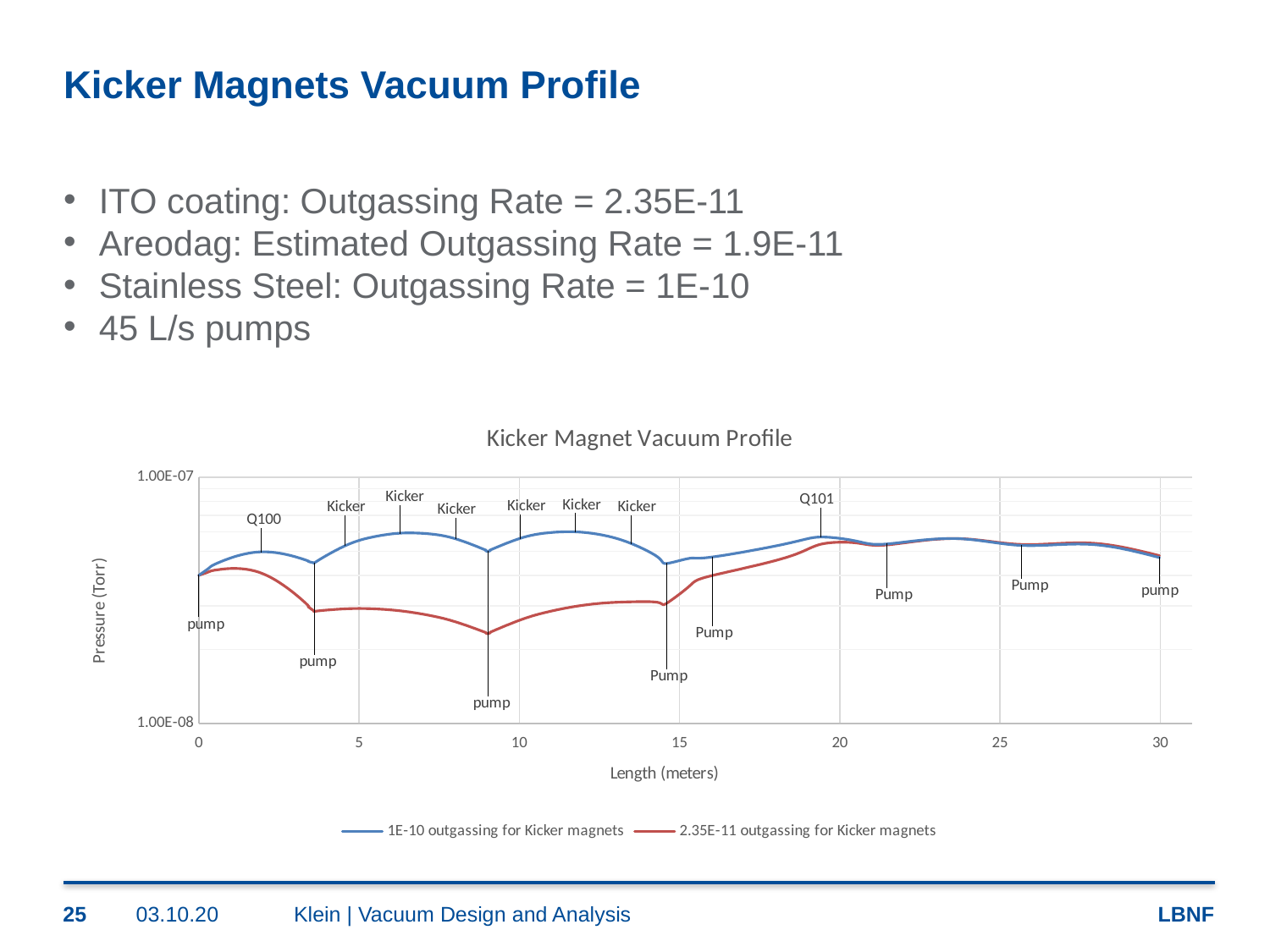
How many points on the chart are annotated with the label "Kicker"? 6 Does the 1E-10 outgassing series rise or fall between 27 meters and 30 meters? fall How many series does the legend of the chart list? 2 At 10 meters, which series shows the higher pressure: the 1E-10 outgassing series or the 2.35E-11 outgassing series? 1E-10 outgassing for Kicker magnets Does the 2.35E-11 outgassing series rise or fall between 9 meters and 20 meters? rise What is the title of the chart? Kicker Magnet Vacuum Profile What is the label of the y-axis of the chart? Pressure (Torr) Is the pressure for the 1E-10 outgassing series at 0 meters greater or less than 1.00E-08? greater Is the pressure for the 2.35E-11 outgassing series at 9 meters greater or less than 1.00E-07? less What kind of chart is shown on the slide? line chart What is the largest value shown on the x-axis of the chart? 30 At 9 meters, which series shows the lower pressure: the 1E-10 outgassing series or the 2.35E-11 outgassing series? 2.35E-11 outgassing for Kicker magnets